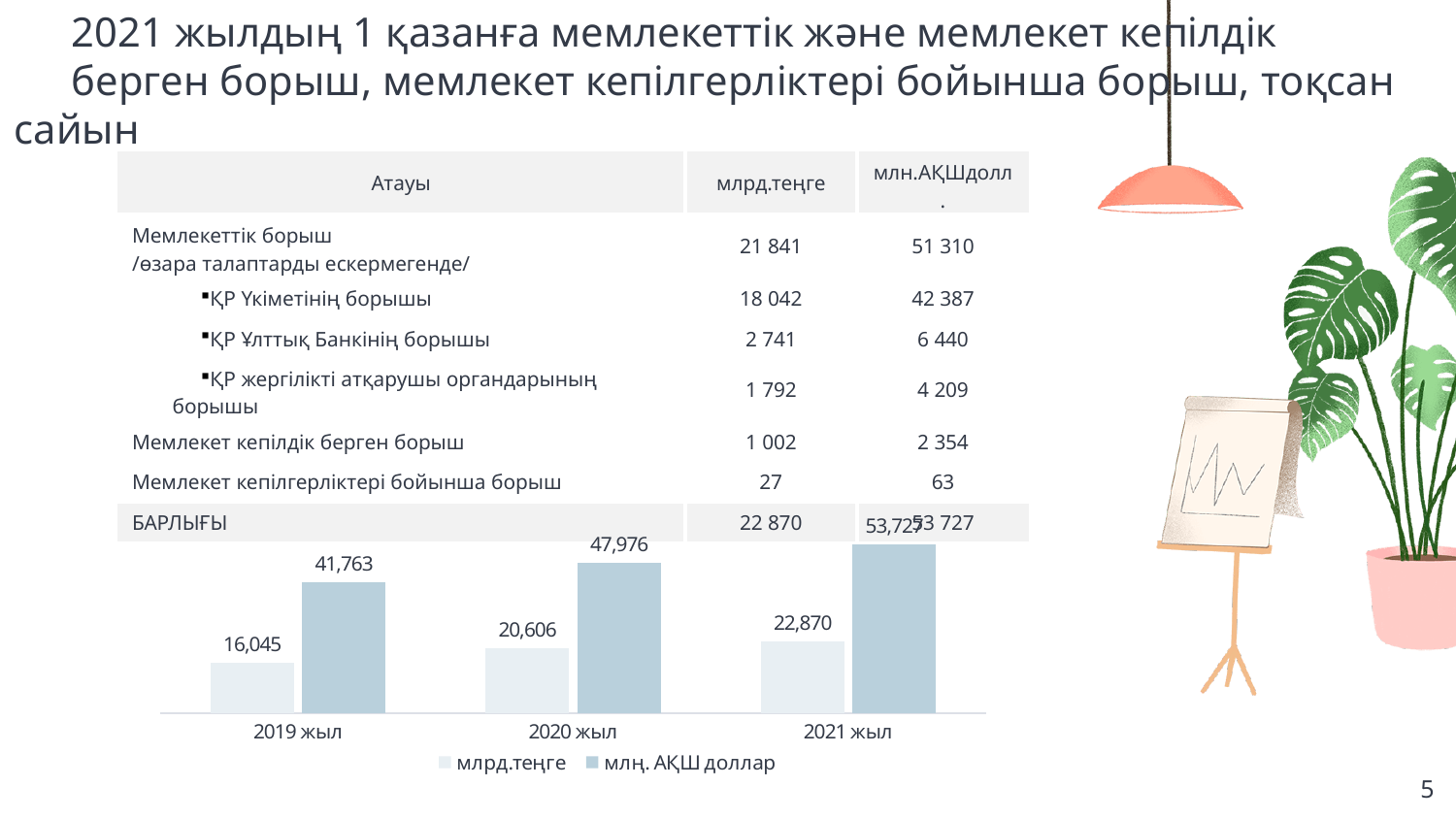
Which year has the lowest value for млрд.теңге? 2019 жыл How many series does the chart legend list? 2 What type of chart is shown on the slide? bar chart How many year categories are shown on the x axis of the chart? 3 What is the difference between the млрд.теңге values for 2020 жыл and 2019 жыл? 4,561 Which is larger in 2020 жыл: the млрд.теңге value or the млн. АҚШ доллар value? млн. АҚШ доллар What is the value for млрд.теңге in 2021 жыл? 22,870 What is the value for млн. АҚШ доллар in 2020 жыл? 47,976 What is the value for млн. АҚШ доллар in 2019 жыл? 41,763 Does the млрд.теңге series rise or fall from 2019 жыл to 2021 жыл? rise What is the value for млрд.теңге in 2019 жыл? 16,045 Which year has the highest value for млн. АҚШ доллар? 2021 жыл